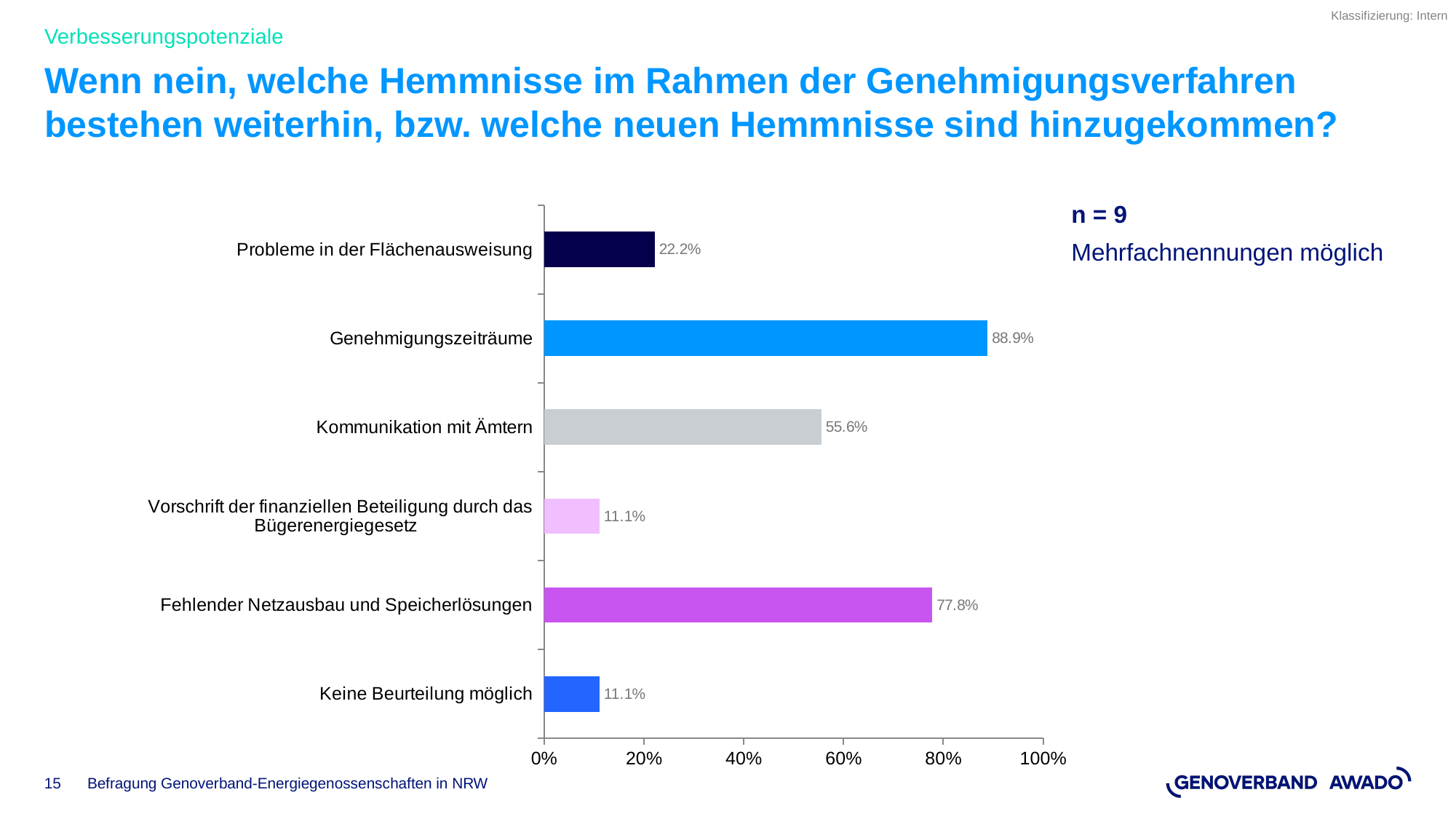
How many categories are shown in the chart? 6 What is the value for Kommunikation mit Ämtern? 55.6% What is the value for Fehlender Netzausbau und Speicherlösungen? 77.8% Is the value for Kommunikation mit Ämtern greater or less than 40%? greater Which is larger, the value for Kommunikation mit Ämtern or the value for Probleme in der Flächenausweisung? Kommunikation mit Ämtern What sample size (n) is stated next to the chart? n = 9 What is the difference between the values for Genehmigungszeiträume and Fehlender Netzausbau und Speicherlösungen? 11.1% What is the value for Probleme in der Flächenausweisung? 22.2% What is the value for Genehmigungszeiträume? 88.9% What kind of chart is shown on the slide? Bar chart Which category has the highest value? Genehmigungszeiträume What is the value for Keine Beurteilung möglich? 11.1%